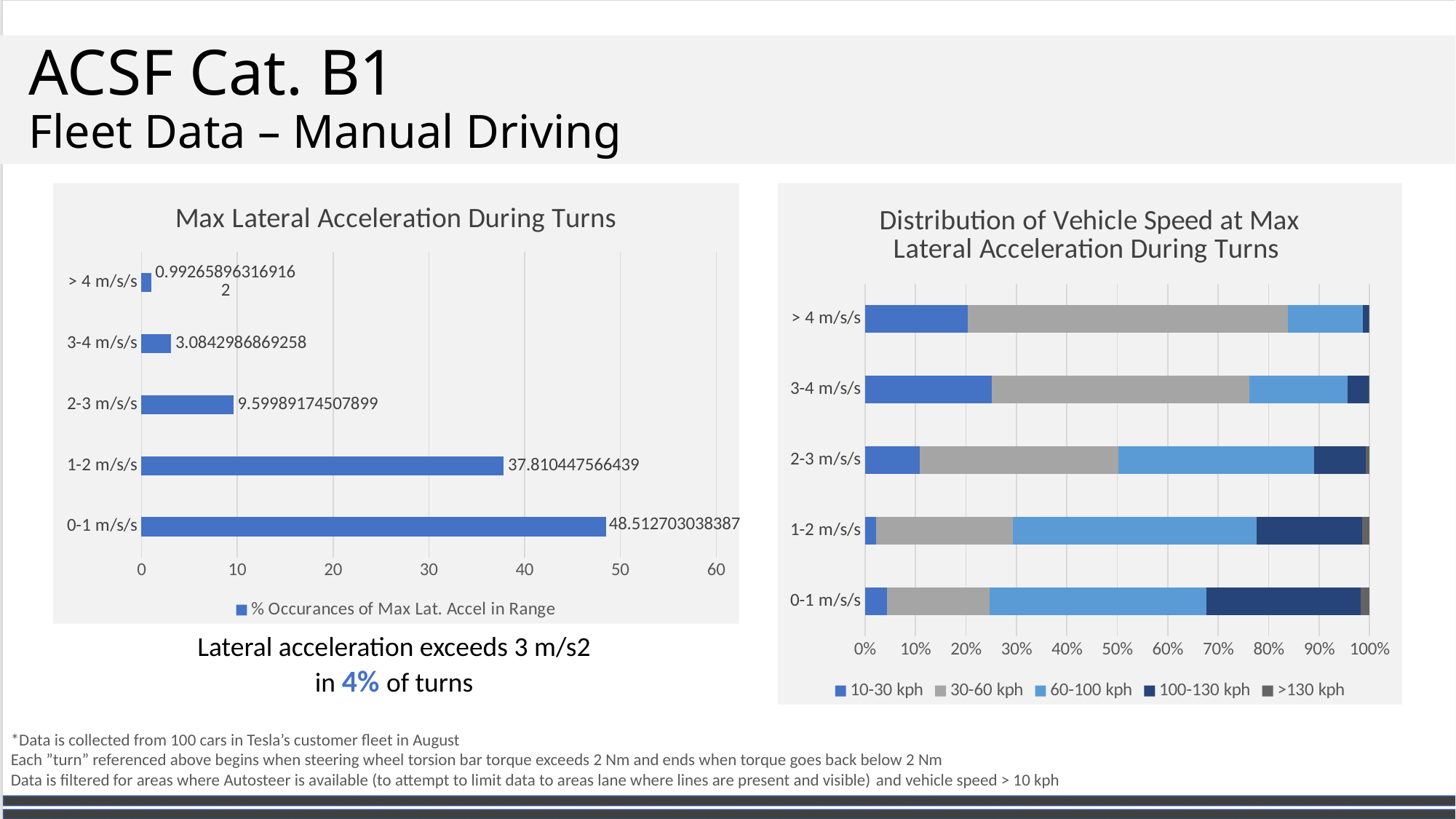
In the 'Max Lateral Acceleration During Turns' chart, what is the difference between the values for 0-1 m/s/s and 1-2 m/s/s? 10.702255471948 What is the legend entry of the 'Max Lateral Acceleration During Turns' chart? % Occurances of Max Lat. Accel in Range In the 'Max Lateral Acceleration During Turns' chart, what is the value for 1-2 m/s/s? 37.810447566439 In the 'Max Lateral Acceleration During Turns' chart, what is the value for 2-3 m/s/s? 9.59989174507899 In the 'Distribution of Vehicle Speed at Max Lateral Acceleration During Turns' chart, which category has the larger 10-30 kph share: > 4 m/s/s or 0-1 m/s/s? > 4 m/s/s In the 'Distribution of Vehicle Speed at Max Lateral Acceleration During Turns' chart, is the 10-30 kph share for > 4 m/s/s greater or less than 10%? greater In the 'Max Lateral Acceleration During Turns' chart, what is the value for 0-1 m/s/s? 48.512703038387 In the 'Max Lateral Acceleration During Turns' chart, which category has the highest value? 0-1 m/s/s How many categories are shown in the 'Max Lateral Acceleration During Turns' chart? 5 In the 'Max Lateral Acceleration During Turns' chart, which category has the lowest value? > 4 m/s/s What kind of chart is the 'Max Lateral Acceleration During Turns' chart? Bar chart How many series does the legend of the 'Distribution of Vehicle Speed at Max Lateral Acceleration During Turns' chart list? 5